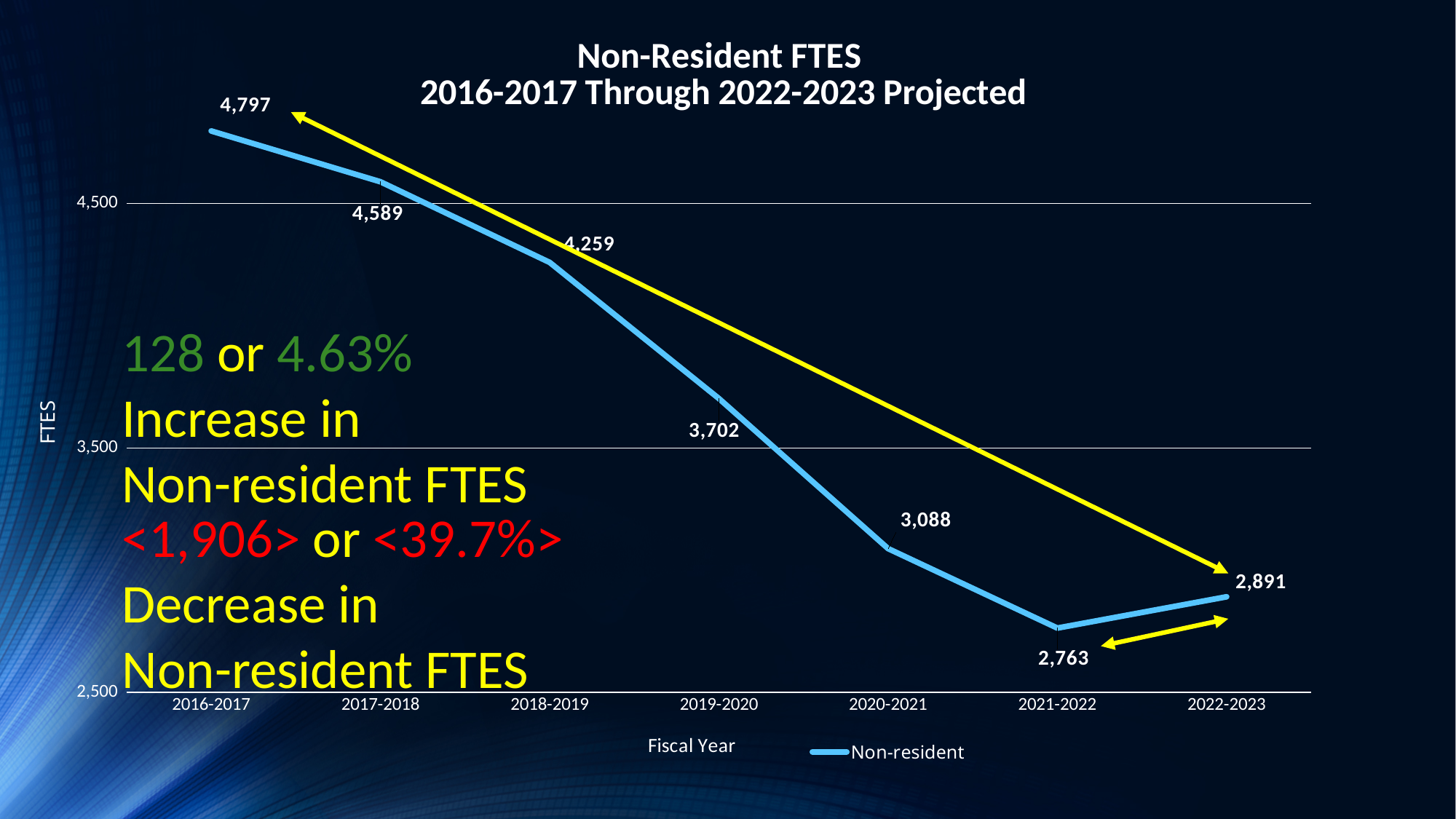
What is the projected Non-resident FTES value for 2022-2023? 2,891 What is the difference in Non-resident FTES between 2016-2017 and 2017-2018? 208 Which is larger, the Non-resident FTES for 2018-2019 or for 2020-2021? 2018-2019 What is the title of the chart? Non-Resident FTES 2016-2017 Through 2022-2023 Projected How many fiscal years are plotted on the chart? 7 Which fiscal year has the highest Non-resident FTES? 2016-2017 What is the difference in Non-resident FTES between 2021-2022 and 2022-2023? 128 What kind of chart is shown on the slide? Line chart What is the Non-resident FTES value for 2016-2017? 4,797 Which fiscal year has the lowest Non-resident FTES? 2021-2022 What is the Non-resident FTES value for 2019-2020? 3,702 Is the Non-resident FTES value for 2019-2020 greater or less than 3,500? greater